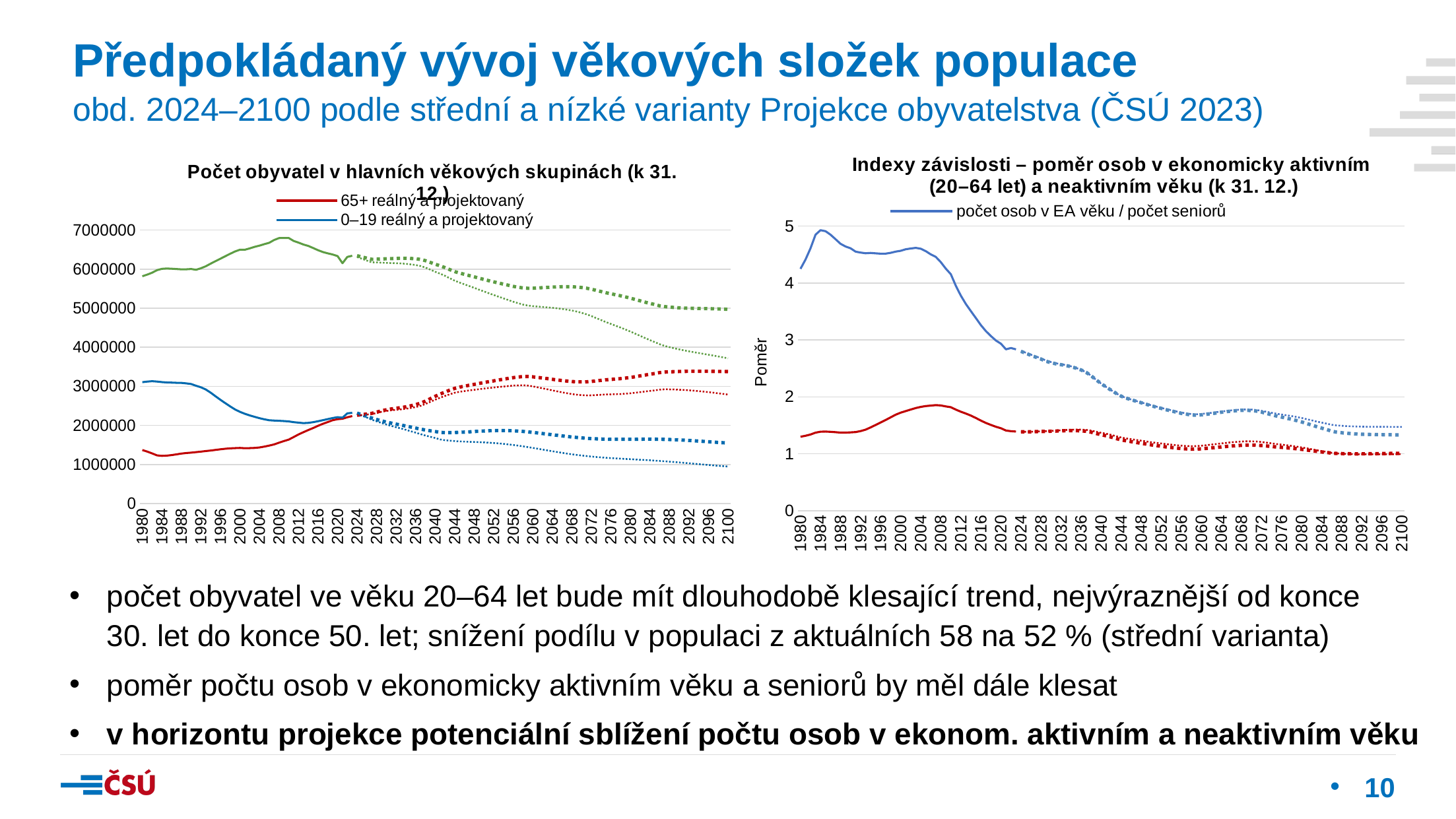
In the right chart, is the value of "počet osob v EA věku / počet seniorů" in 1984 greater or less than 4? greater In the left chart, does the series "0–19 reálný a projektovaný" rise or fall from 1980 to 2100? fall What kind of chart is the right chart titled "Indexy závislosti"? line chart In the right chart, is the value of "počet osob v EA věku / počet seniorů" in 2100 greater or less than 2? less What is the y-axis label of the right chart "Indexy závislosti"? Poměr In the right chart "Indexy závislosti", how many series does the legend list? 1 In the left chart "Počet obyvatel v hlavních věkových skupinách", how many series does the legend list? 2 In the right chart, does the series "počet osob v EA věku / počet seniorů" rise or fall from 2024 to 2100? fall What kind of chart is the left chart titled "Počet obyvatel v hlavních věkových skupinách (k 31. 12.)"? line chart In the left chart, is the value of "65+ reálný a projektovaný" in 1980 greater or less than 2000000? less In the left chart, which series is larger in 1980: "65+ reálný a projektovaný" or "0–19 reálný a projektovaný"? 0–19 reálný a projektovaný